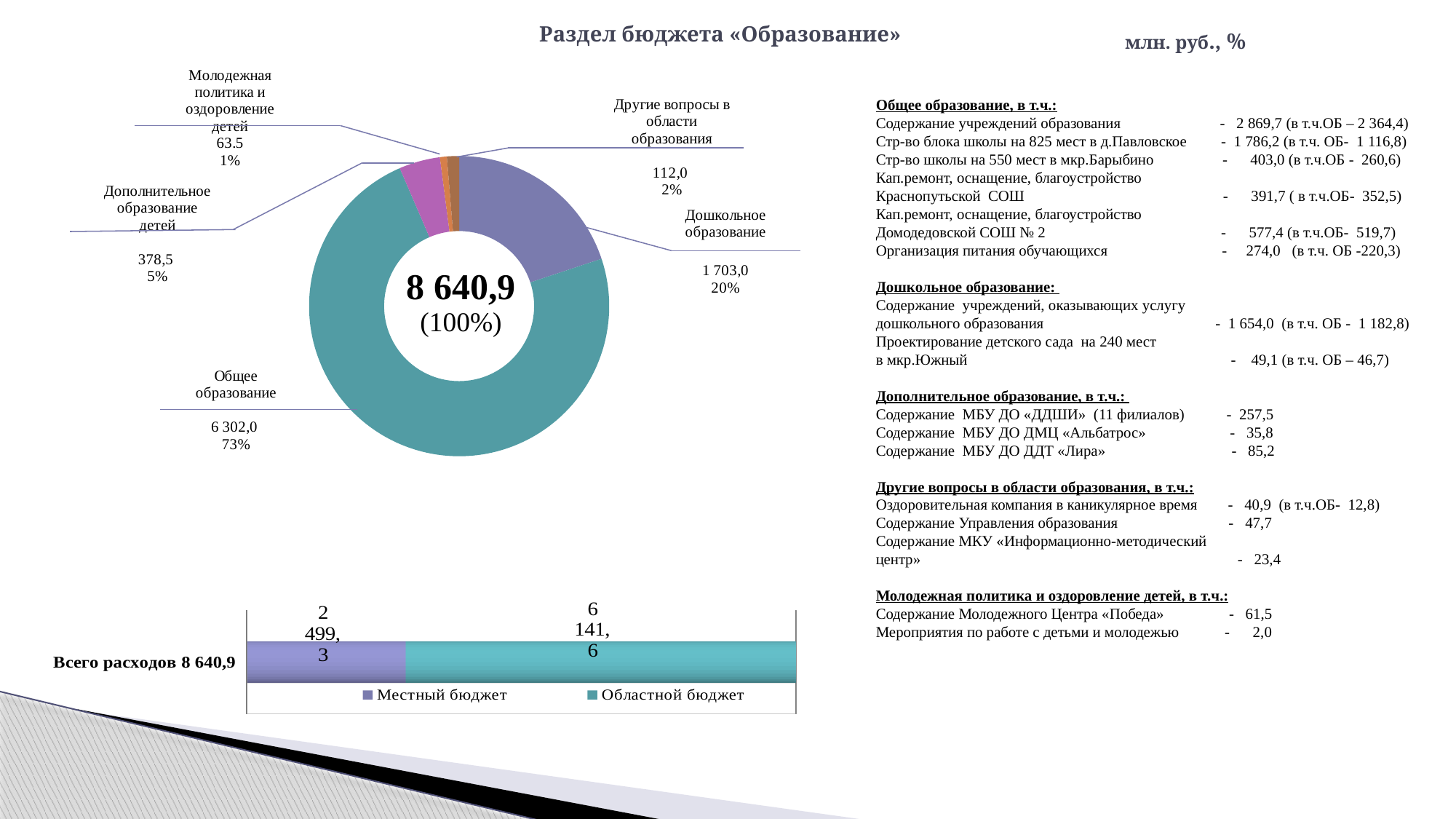
In the bar chart at the bottom, what is the value for Местный бюджет? 2 499,3 In the donut chart, how many categories are shown? 5 In the bar chart at the bottom, how many series does the legend list? 2 In the donut chart, what is the difference between Дошкольное образование and Другие вопросы в области образования? 1 591,0 In the donut chart, what total value is shown in the centre? 8 640,9 In the bar chart at the bottom, which is larger, Местный бюджет or Областной бюджет? Областной бюджет In the donut chart, what is the value for Общее образование? 6 302,0 In the bar chart at the bottom, what is the value for Областной бюджет? 6 141,6 In the donut chart, which category has the smallest value? Молодежная политика и оздоровление детей In the donut chart, which category has the largest value? Общее образование In the donut chart, what is the value for Дополнительное образование детей? 378,5 In the donut chart, what share of the total does Дошкольное образование represent? 20%